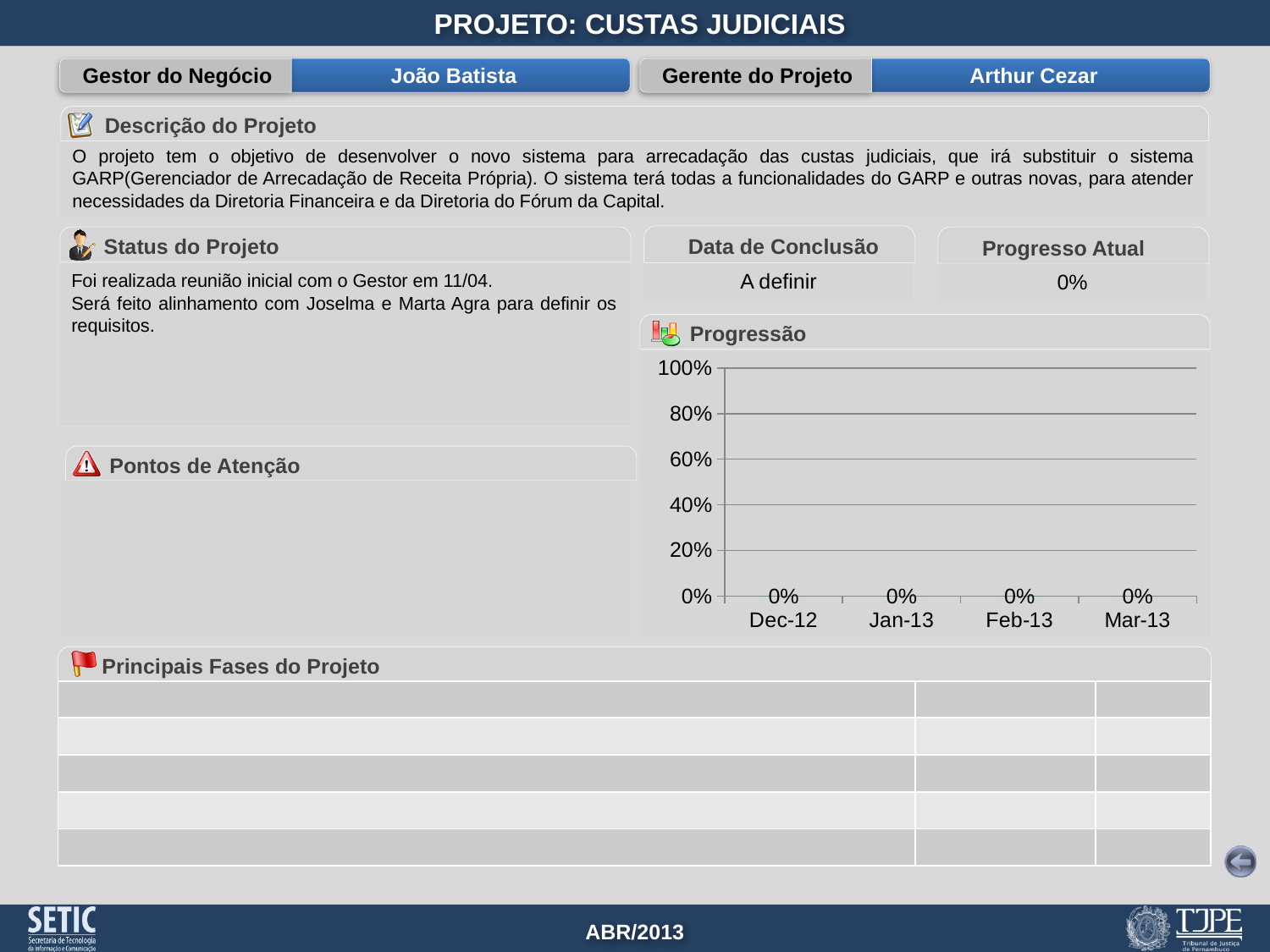
In the Progressão chart, is the value for Mar-13 greater or less than 20%? less What is the highest value shown on the y axis of the Progressão chart? 100% How many categories are shown on the x axis of the Progressão chart? 4 In the Progressão chart, which category is the first on the x axis? Dec-12 In the Progressão chart, what is the value for Feb-13? 0% In the Progressão chart, do the values rise, fall, or stay flat from Dec-12 to Mar-13? stay flat What is the title of the chart on the slide? Progressão In the Progressão chart, what is the value for Dec-12? 0% In the Progressão chart, what is the value for Jan-13? 0% In the Progressão chart, what is the value for Mar-13? 0% In the Progressão chart, what is the difference between the values for Mar-13 and Dec-12? 0%